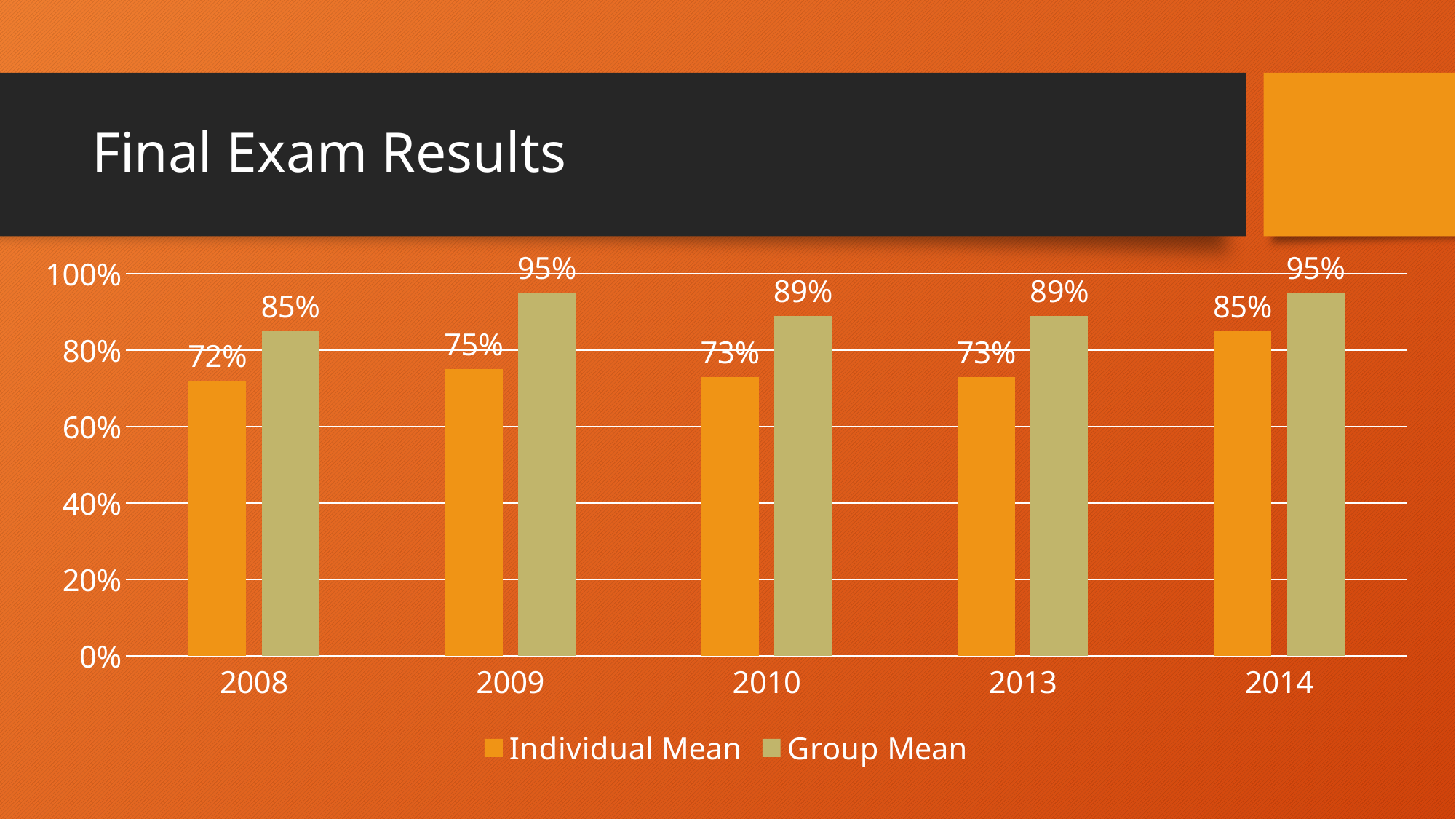
What kind of chart is shown on the slide? Bar chart Which year has the highest Individual Mean? 2014 What is the Group Mean for 2010? 89% What is the Individual Mean for 2008? 72% What is the Individual Mean for 2014? 85% What is the difference between the Group Mean and the Individual Mean in 2009? 20% How many series does the legend list? 2 Which is larger in 2013, the Individual Mean or the Group Mean? Group Mean Which year has the lowest Individual Mean? 2008 How many years are shown on the x axis? 5 What is the title of the slide? Final Exam Results What is the difference between the Individual Mean in 2014 and the Individual Mean in 2013? 12%